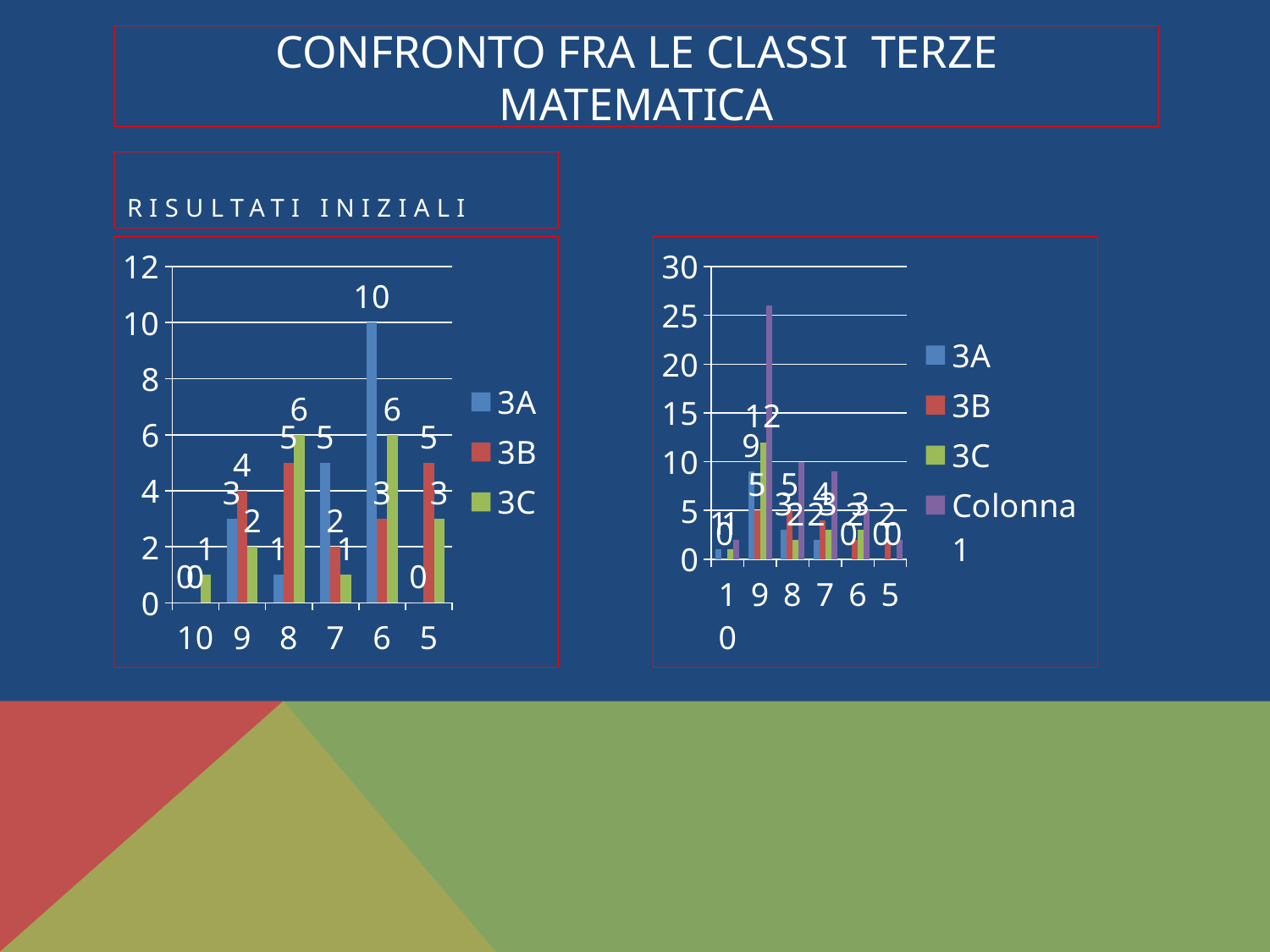
What kind of chart is the left chart (RISULTATI INIZIALI)? bar chart On the left chart (RISULTATI INIZIALI), which category has the highest value for 3A? 6 On the left chart (RISULTATI INIZIALI), how many categories are shown on the x axis? 6 On the left chart (RISULTATI INIZIALI), what is the value for 3A at category 6? 10 On the right chart, what is the fourth legend entry? Colonna 1 On the left chart (RISULTATI INIZIALI), at category 9, which series has the larger value, 3B or 3C? 3B On the right chart, how many series does the legend list? 4 On the right chart, is the value of the Colonna 1 bar at category 9 greater or less than 20? greater On the left chart (RISULTATI INIZIALI), what is the value for 3C at category 8? 6 On the left chart (RISULTATI INIZIALI), what is the value for 3B at category 5? 5 On the left chart (RISULTATI INIZIALI), how many series does the legend list? 3 On the left chart (RISULTATI INIZIALI), what is the difference between the 3A and 3B values at category 6? 7